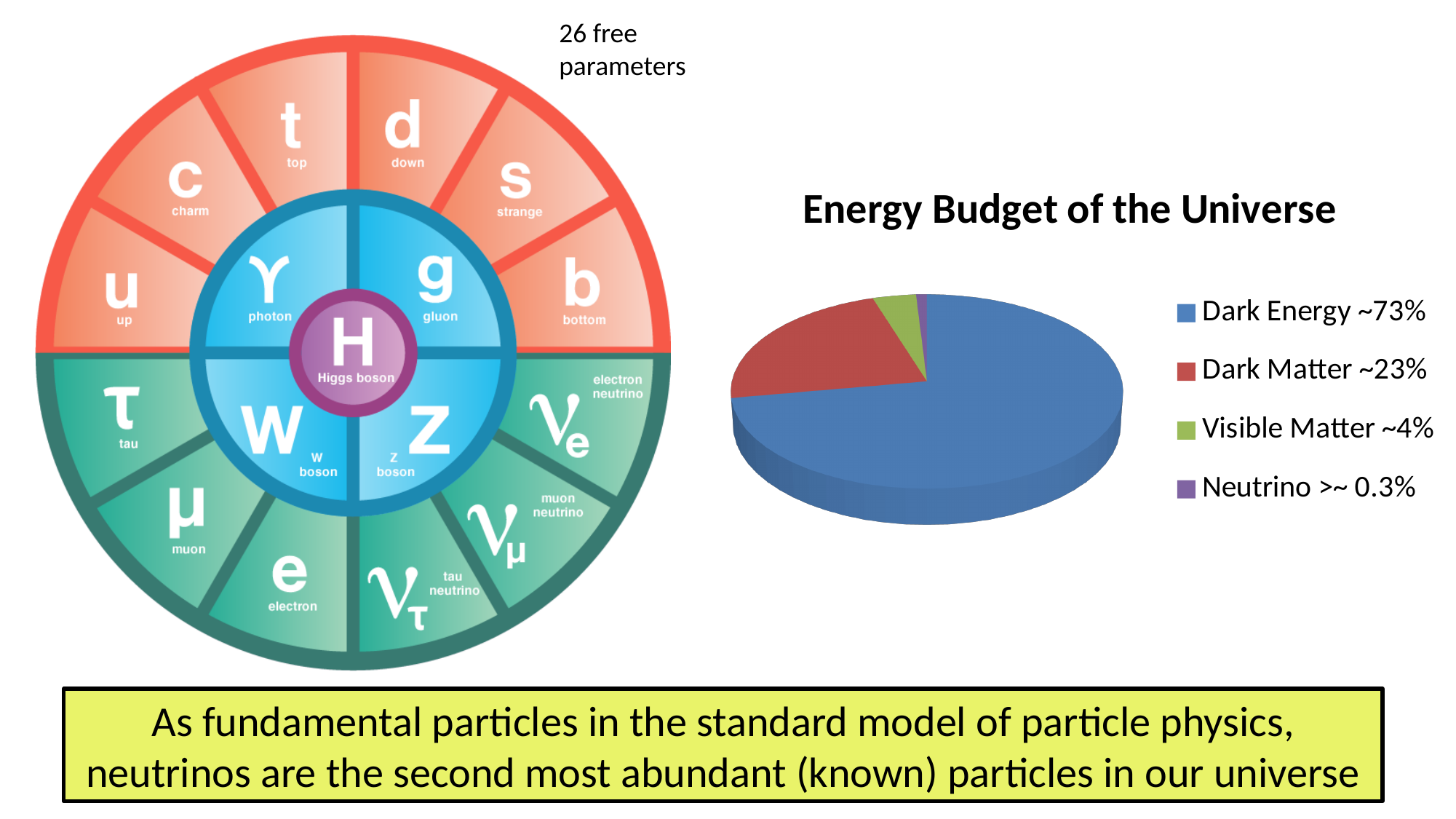
Which category has the largest slice in the Energy Budget of the Universe pie chart? Dark Energy In the Energy Budget of the Universe chart, what share is shown for Visible Matter in the legend? ~4% In the Energy Budget of the Universe chart, what share is shown for Dark Energy in the legend? ~73% What colour is the Dark Energy slice in the Energy Budget of the Universe pie chart? blue How many slices does the Energy Budget of the Universe pie chart have? 4 Which category has the smallest slice in the Energy Budget of the Universe pie chart? Neutrino In the Energy Budget of the Universe chart, what value is shown for Neutrino in the legend? >~ 0.3% In the Energy Budget of the Universe chart, what share is shown for Dark Matter in the legend? ~23% What is the title of the pie chart on the right of the slide? Energy Budget of the Universe How many entries does the legend of the Energy Budget of the Universe chart list? 4 What kind of chart is the Energy Budget of the Universe chart? pie chart In the Energy Budget of the Universe chart, which is larger, Dark Matter or Visible Matter? Dark Matter